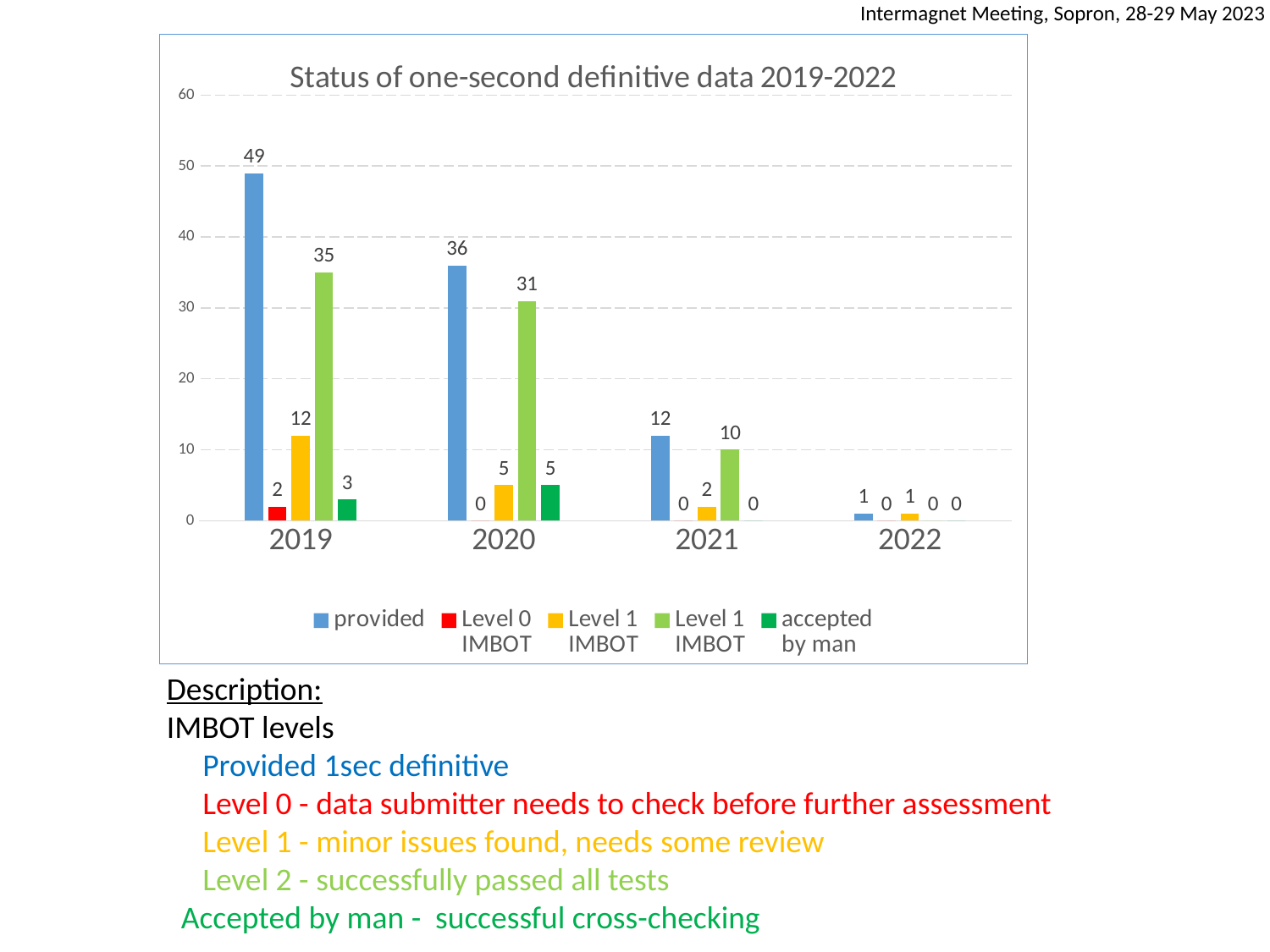
Does the 'provided' series rise or fall from 2019 to 2022? fall What is the value of the 'Level 0 IMBOT' series for 2019? 2 How many series does the legend list? 5 What kind of chart is shown on the slide? bar chart Is the 'provided' value for 2019 greater or less than 40? greater What is the value of the 'provided' series for 2019? 49 How many years are shown on the x axis? 4 Which year has the larger 'accepted by man' value, 2019 or 2020? 2020 What is the value of the 'accepted by man' series for 2020? 5 Which year has the highest value for the 'provided' series? 2019 What is the value of the light green series for 2021? 10 What is the difference between the 'provided' values for 2019 and 2020? 13